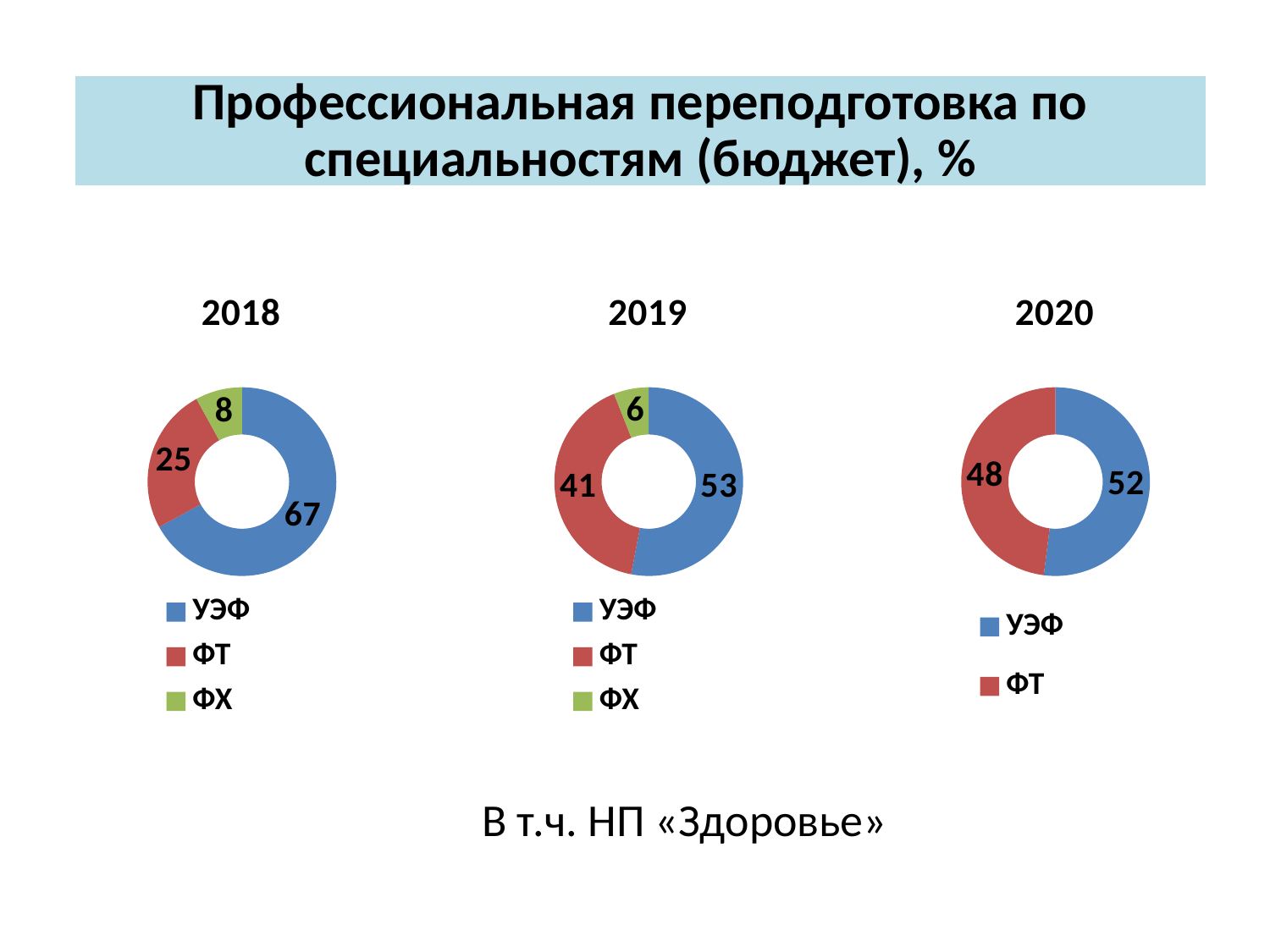
In the 2018 chart, which category has the largest share? УЭФ In the 2019 chart, what is the value for ФТ? 41 In the 2018 chart, what is the value for УЭФ? 67 In the 2020 chart, which is larger, УЭФ or ФТ? УЭФ What is the title of the slide above the charts? Профессиональная переподготовка по специальностям (бюджет), % What kind of chart is the 2018 chart? Doughnut chart In the 2018 chart, what is the difference between the values for УЭФ and ФТ? 42 How many entries does the legend of the 2019 chart list? 3 In the 2019 chart, which category has the smallest share? ФХ In the 2018 chart, what is the value for ФХ? 8 How many categories does the 2020 chart show? 2 In the 2020 chart, what is the value for ФТ? 48